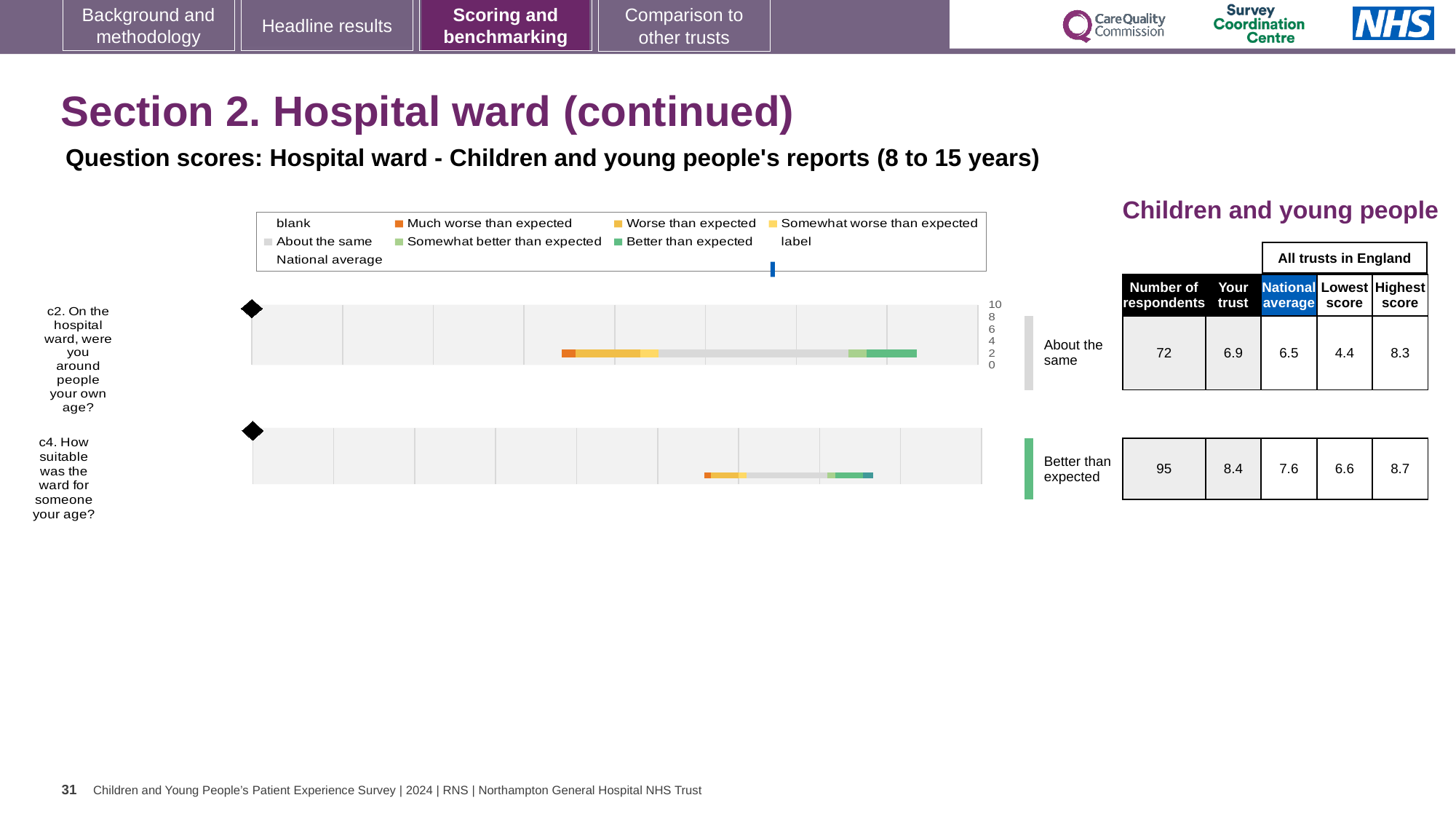
What is the lowest score among all trusts in England for question c4? 6.6 What is the national average score for question c2? 6.5 What kind of chart is used to show the question scores? Bar chart What is the 'Your trust' score for question c4 (How suitable was the ward for someone your age?)? 8.4 How many questions are plotted on this slide? 2 What is the 'Your trust' score for question c2 (On the hospital ward, were you around people your own age?)? 6.9 How many respondents answered question c4? 95 What is the difference between the 'Your trust' score and the national average for question c4? 0.8 What is the difference between the highest and lowest scores for question c2? 3.9 What is the highest score among all trusts in England for question c2? 8.3 Which benchmark category is question c4 rated as? Better than expected Which question has the higher 'Your trust' score, c2 or c4? c4